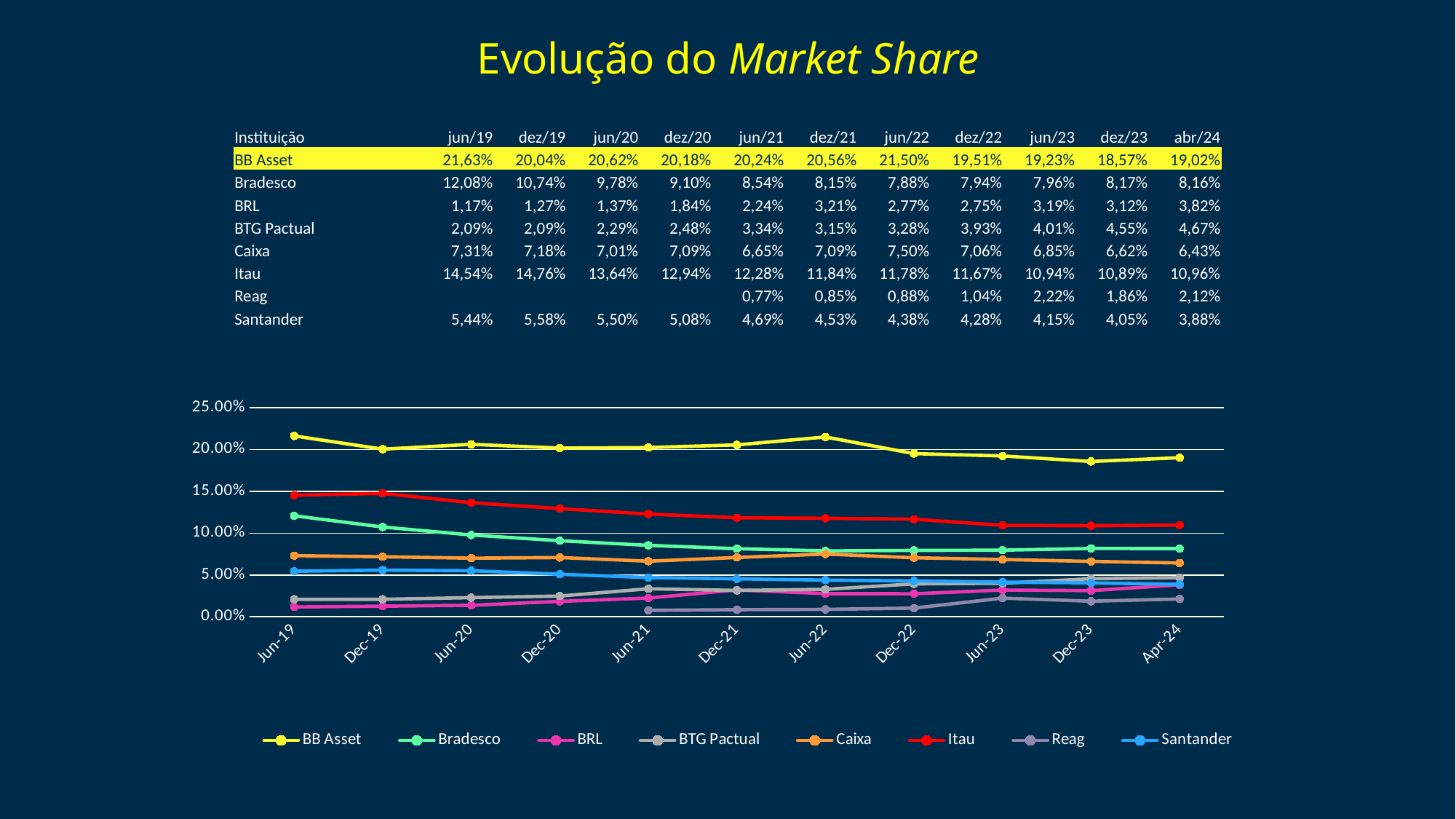
Does Itau's market share rise or fall overall from Jun-19 to Apr-24? fall What was BB Asset's market share in jun/19? 21,63% Which institution had the highest market share in abr/24? BB Asset What was Itau's market share in abr/24? 10,96% Which institution had the lowest market share in abr/24? Reag How many series does the chart legend list? 8 What was Reag's market share in jun/23? 2,22% How many time points are plotted along the x axis of the chart? 11 In abr/24, which had the larger market share, Caixa or Santander? Caixa What kind of chart is shown on the slide? line chart By how many percentage points did BB Asset's market share change from jun/19 (21,63%) to abr/24 (19,02%)? 2,61 percentage points lower Is Itau's value at Jun-19 greater or less than 10.00%? greater